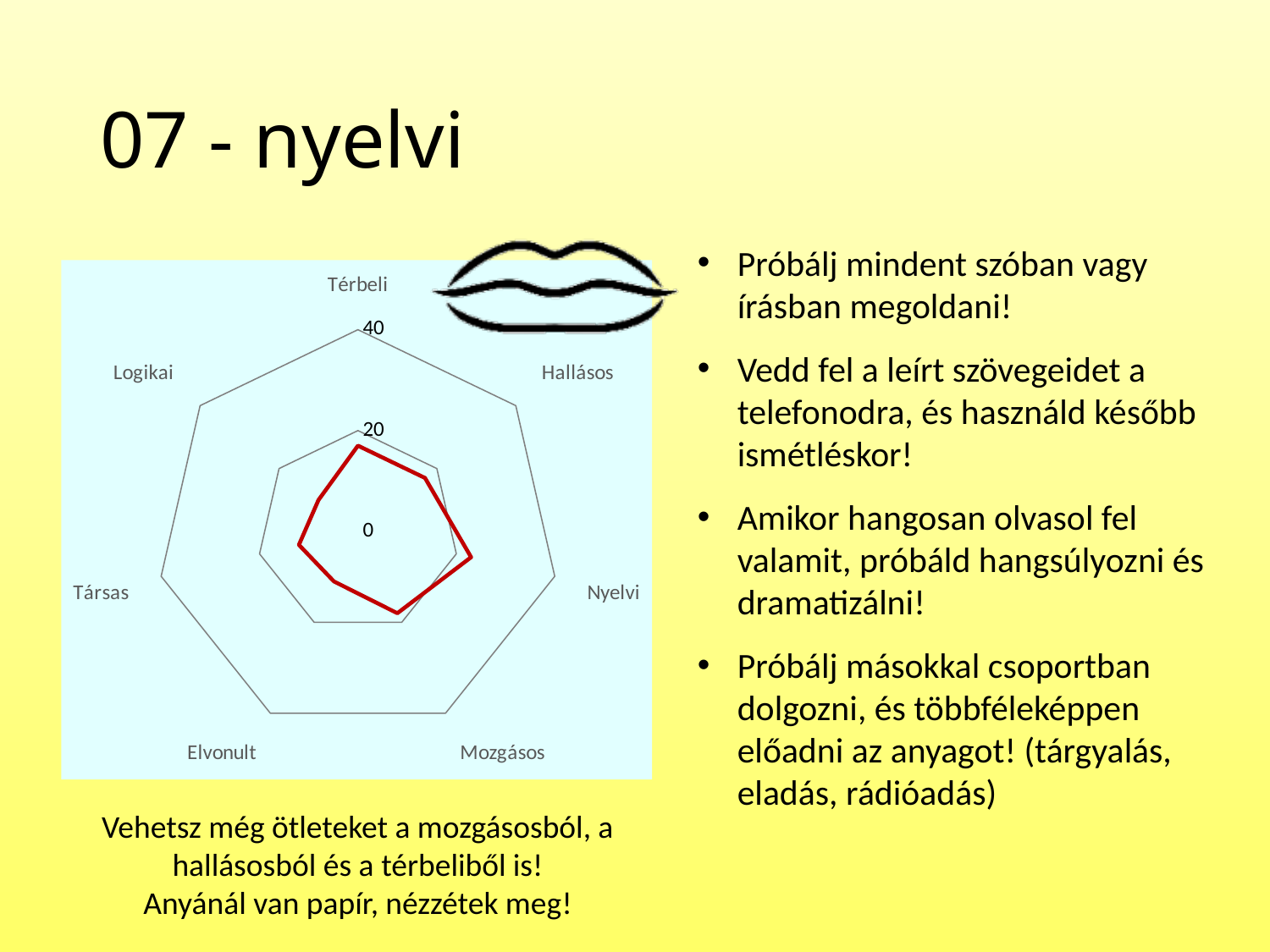
What kind of chart is shown on the slide? radar chart Is the value for Elvonult greater or less than 20? less What colour is the data line on the radar chart? red Is the value for Társas greater or less than 20? less What is the highest tick value shown on the radar chart's axis? 40 Which is larger, the value for Térbeli or the value for Elvonult? Térbeli How many categories (axes) does the radar chart have? 7 Which category has the highest value on the radar chart? Nyelvi Is the value for Hallásos greater or less than 40? less Which is larger, the value for Nyelvi or the value for Logikai? Nyelvi